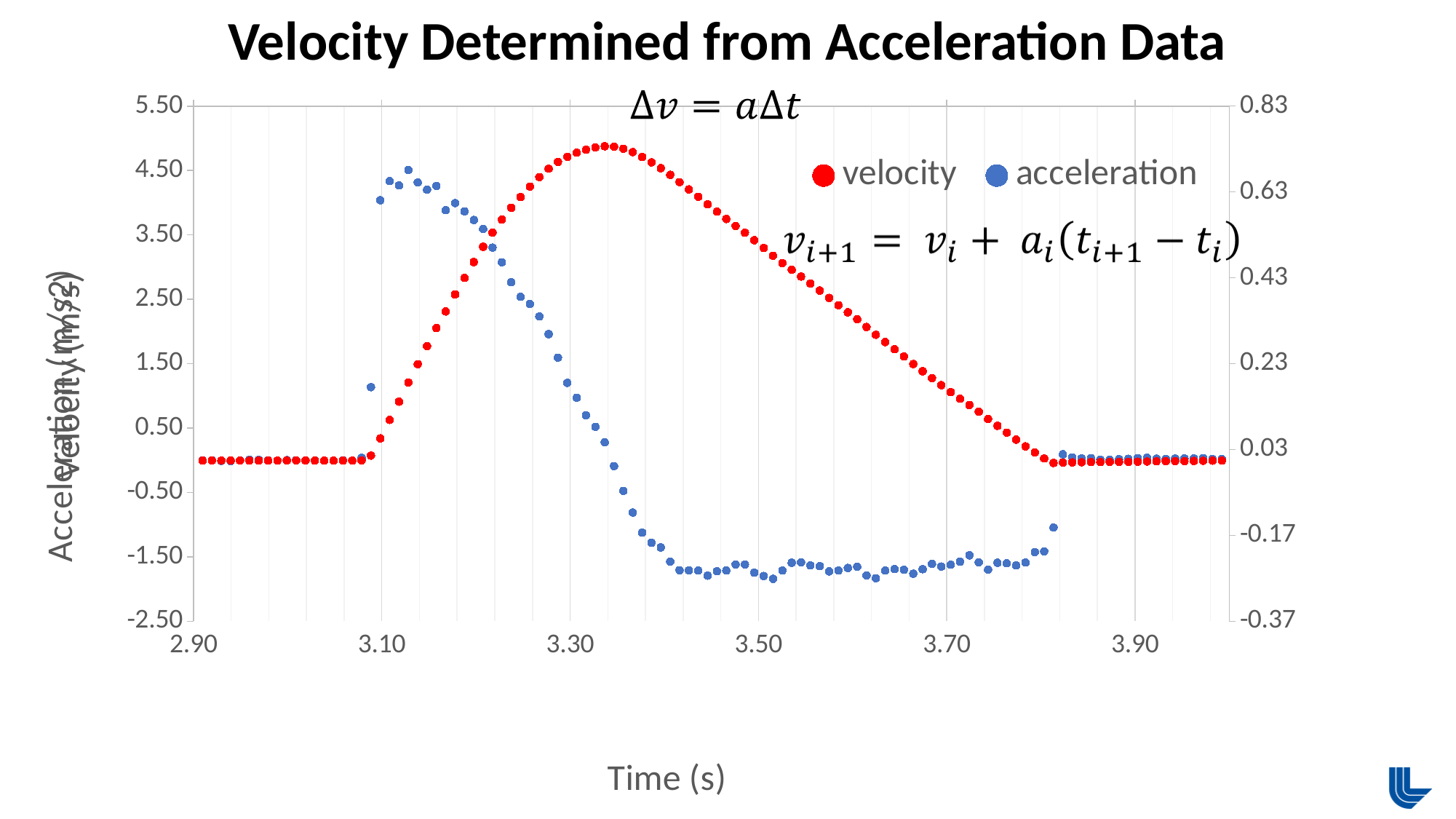
How many series does the legend list? 2 At time 3.50, which series is plotted higher on the chart, velocity or acceleration? velocity What is the title of the chart? Velocity Determined from Acceleration Data Between time 3.40 and 3.80, does the velocity series rise or fall? fall Between time 3.30 and 3.40, does the acceleration series rise or fall? fall What is the label of the x axis? Time (s) Which series is plotted in red? velocity What kind of chart is shown on the slide? scatter chart Which series reaches the highest point on the chart? velocity Between time 3.10 and 3.30, does the velocity series rise or fall? rise